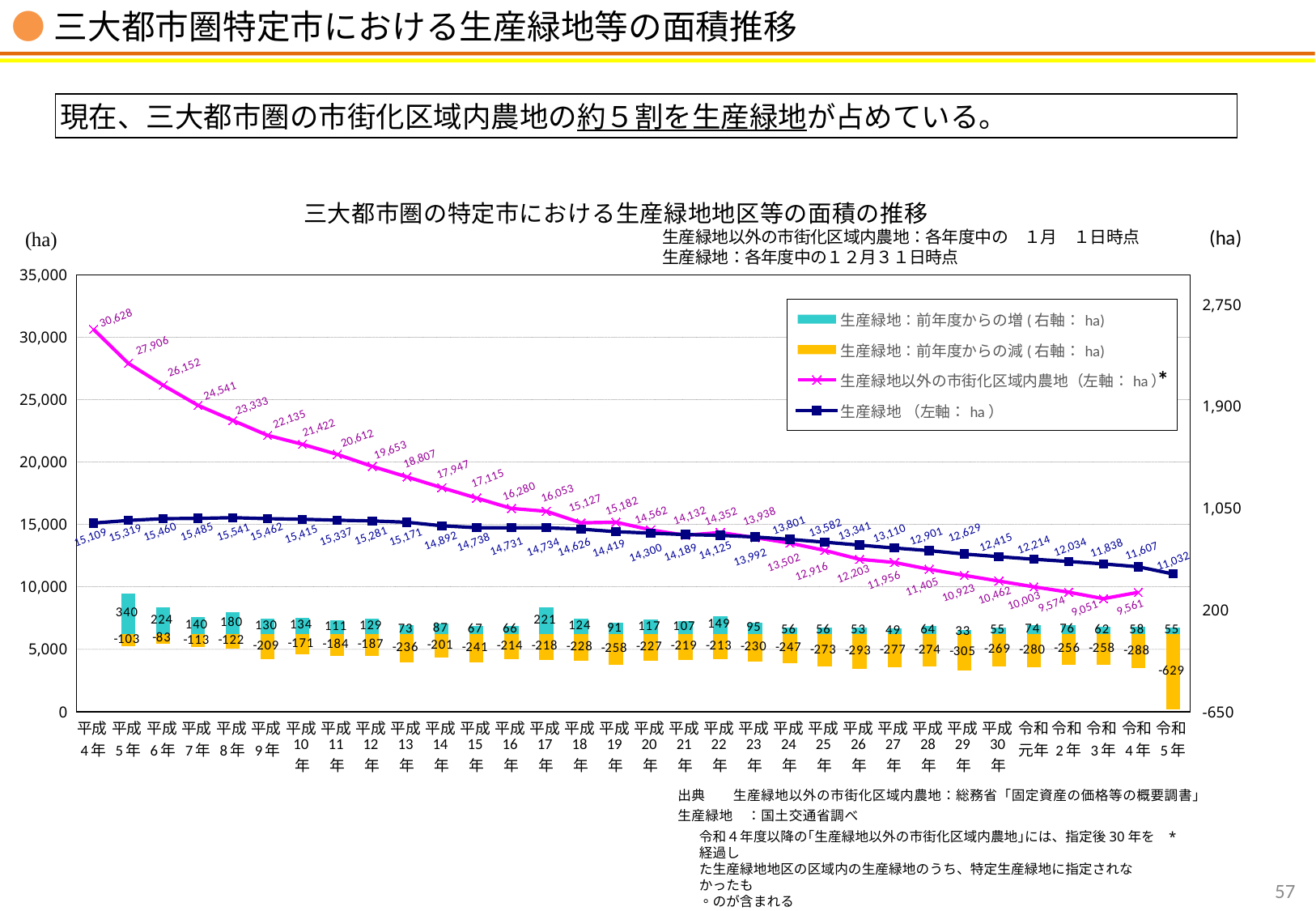
What is the value of 生産緑地 (左軸) for 令和5年? 11,032 How many series does the legend list? 4 For 平成19年, which is larger: 生産緑地以外の市街化区域内農地 or 生産緑地? 生産緑地以外の市街化区域内農地 What is the difference between the 生産緑地 value for 平成4年 and for 令和5年? 4,077 In which year does the 生産緑地以外の市街化区域内農地 line reach its lowest value? 令和3年 In which year does the 生産緑地 line reach its highest value? 平成8年 What is the value of the 生産緑地：前年度からの減 bar for 令和5年? -629 What kind of chart is this? Combined line and bar chart What is the value of 生産緑地 (左軸) for 平成4年? 15,109 What is the value of the 生産緑地：前年度からの増 bar for 平成5年? 340 What is the value of 生産緑地以外の市街化区域内農地 for 平成4年? 30,628 Does the 生産緑地以外の市街化区域内農地 line generally rise or fall from 平成4年 to 令和3年? Fall